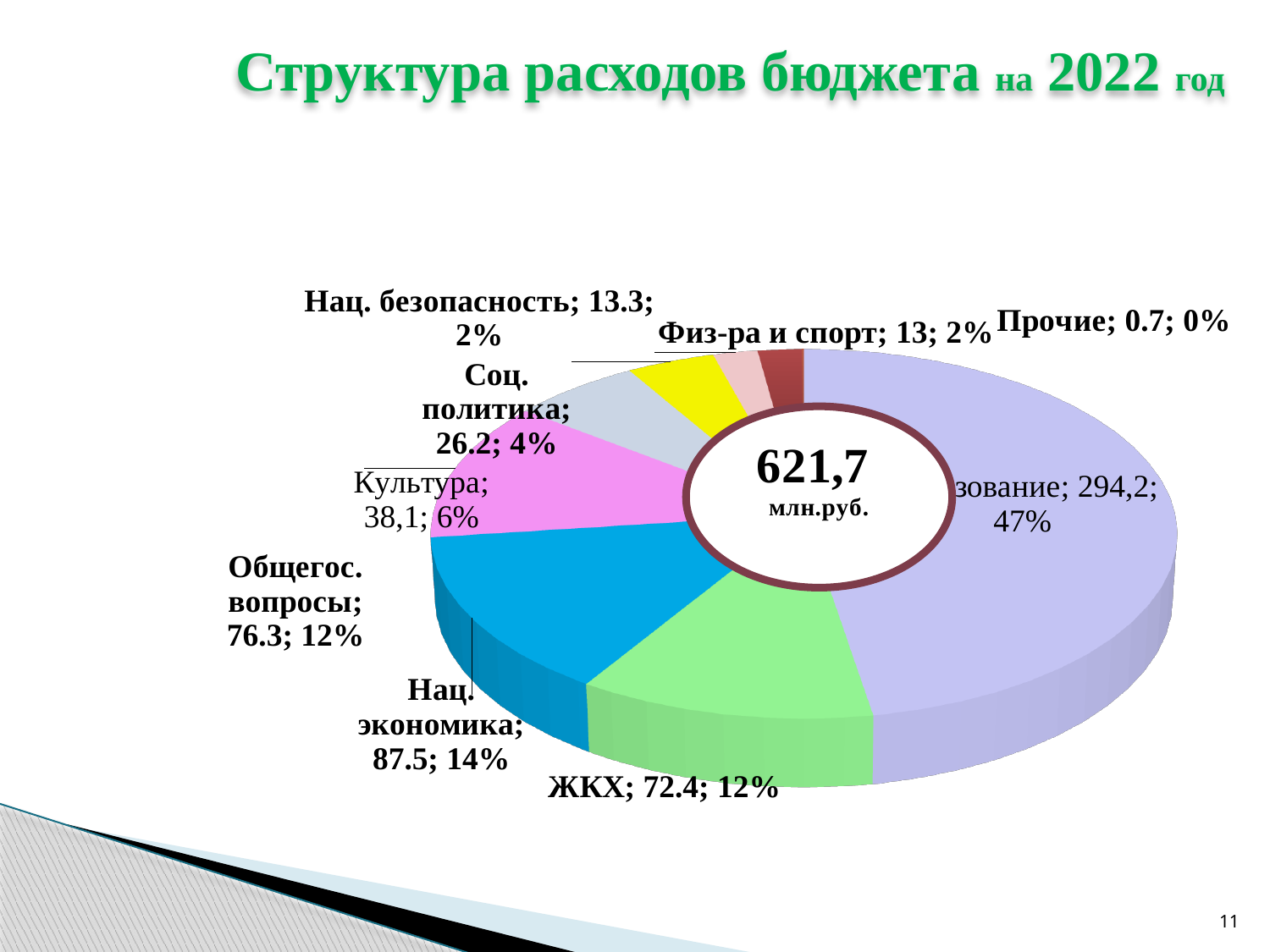
Which category has the smallest slice? Прочие What value is shown for Культура? 38,1 What kind of chart is shown on the slide? pie chart What value is shown for Нац. экономика? 87.5 Which is larger, Общегос. вопросы or ЖКХ? Общегос. вопросы How many slices does the pie chart have? 9 What value is shown for Физ-ра и спорт? 13 What is the difference between the values for Нац. экономика and Общегос. вопросы? 11.2 What share of the pie does ЖКХ have? 12% What share of the pie does Соц. политика have? 4% What percentage is shown for the largest slice of the pie? 47% What total is printed in the centre of the pie chart? 621,7 млн.руб.